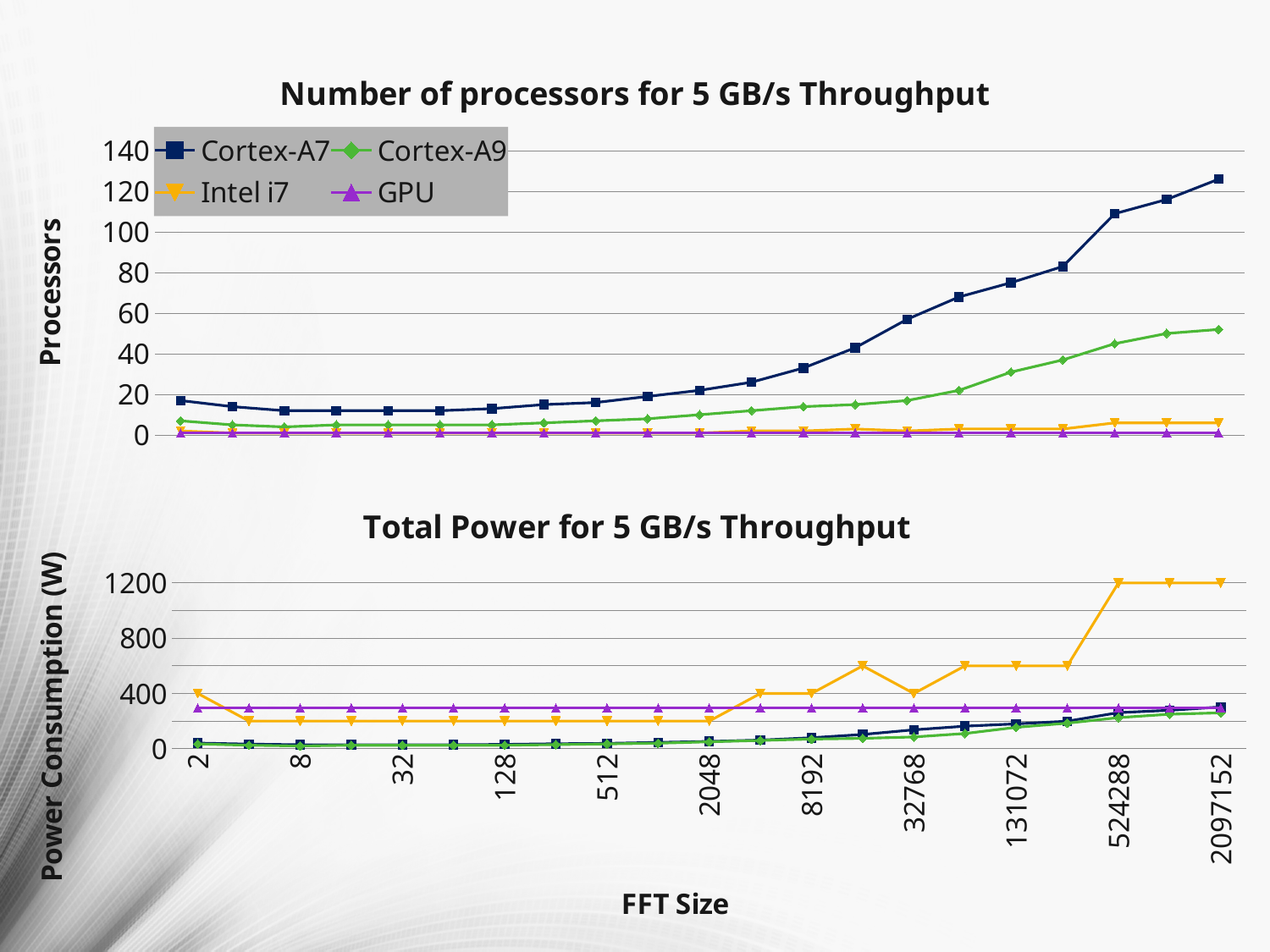
In the top chart, which series has the lowest number of processors at FFT size 2097152? GPU In the top chart, does the Cortex-A7 series rise or fall as FFT size increases from 2048 to 2097152? rise In the top chart, is the value for Cortex-A7 at FFT size 2097152 greater or less than 120? greater In the bottom chart, 'Total Power for 5 GB/s Throughput', which series has the highest power consumption at FFT size 2097152? Intel i7 How many series does the legend of the top chart list? 4 In the top chart, which series has the highest number of processors at FFT size 2097152? Cortex-A7 In the bottom chart, is the value for GPU at FFT size 8192 greater or less than 400? less What is the label of the x axis shared by the charts? FFT Size In the top chart, which is larger at FFT size 131072: Cortex-A7 or Cortex-A9? Cortex-A7 What kind of chart is the top chart, 'Number of processors for 5 GB/s Throughput'? line chart In the bottom chart, is the value for Intel i7 at FFT size 2097152 greater or less than 800? greater